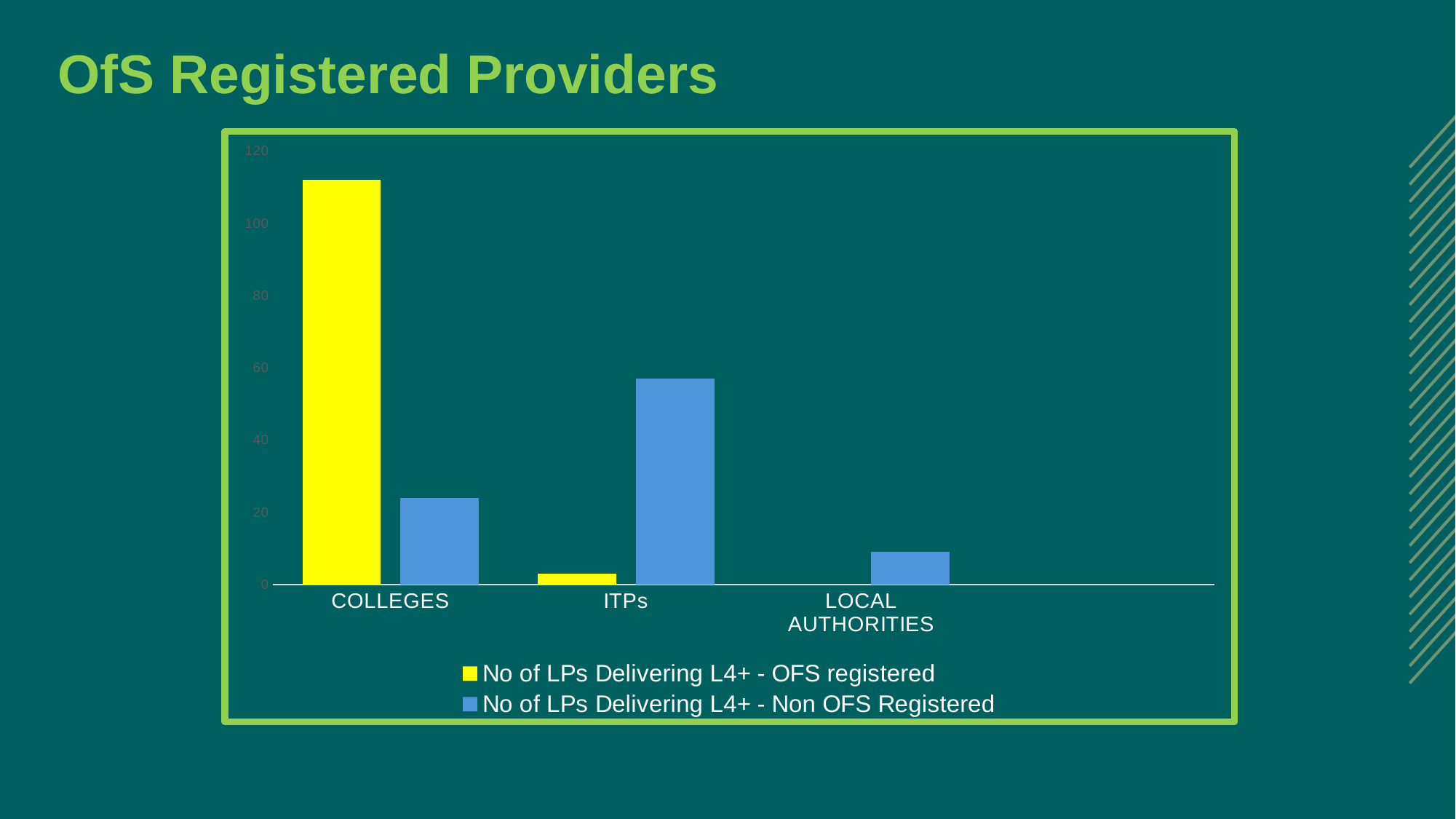
How many series does the chart's legend list? 2 For ITPs, which series has the larger value: OFS registered or Non OFS Registered? Non OFS Registered Which category has the highest value for 'No of LPs Delivering L4+ - OFS registered'? COLLEGES Which category has the lowest value for 'No of LPs Delivering L4+ - Non OFS Registered'? LOCAL AUTHORITIES Is the value for ITPs in the 'Non OFS Registered' series greater or less than 40? greater What colour represents the 'No of LPs Delivering L4+ - OFS registered' series? yellow Is the value for COLLEGES in the 'OFS registered' series greater or less than 100? greater For COLLEGES, which series has the larger value: OFS registered or Non OFS Registered? OFS registered Which category has the highest value for 'No of LPs Delivering L4+ - Non OFS Registered'? ITPs Is the value for LOCAL AUTHORITIES in the 'Non OFS Registered' series greater or less than 20? less How many categories are shown on the x axis of the chart? 3 What kind of chart is shown on the slide? bar chart